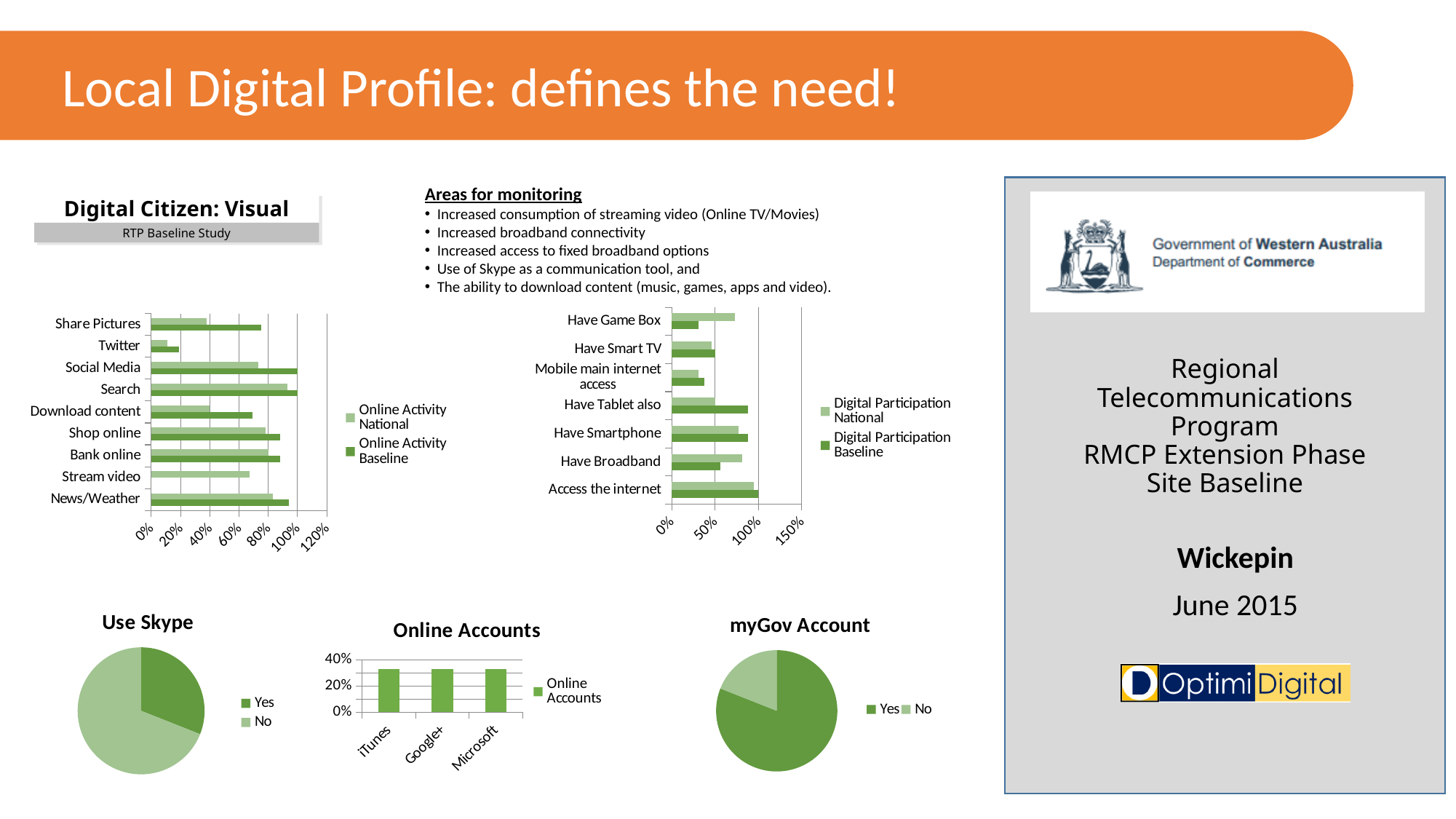
On the Digital Participation chart, which category has the highest Digital Participation Baseline value? Access the internet On the Online Activity chart, which category has the lowest Online Activity Baseline value? Stream video How many series does the legend of the Online Activity chart list? 2 On the Online Activity chart, which is larger for Social Media: Online Activity National or Online Activity Baseline? Online Activity Baseline On the Digital Participation chart, which is larger for Have Game Box: Digital Participation National or Digital Participation Baseline? Digital Participation National What kind of chart is the Online Accounts chart? bar chart On the Use Skype pie chart, which slice is larger: Yes or No? No How many categories are shown on the Digital Participation chart (the middle bar chart with Have Game Box, Have Smart TV, etc.)? 7 On the Online Accounts chart, is the value for iTunes greater or less than 20%? greater On the Online Activity chart, is the Online Activity Baseline value for Twitter greater or less than 40%? less On the Online Activity chart, is the Online Activity Baseline value for Social Media greater or less than 80%? greater How many categories are shown on the Online Activity chart (the left bar chart with Share Pictures, Twitter, etc.)? 9